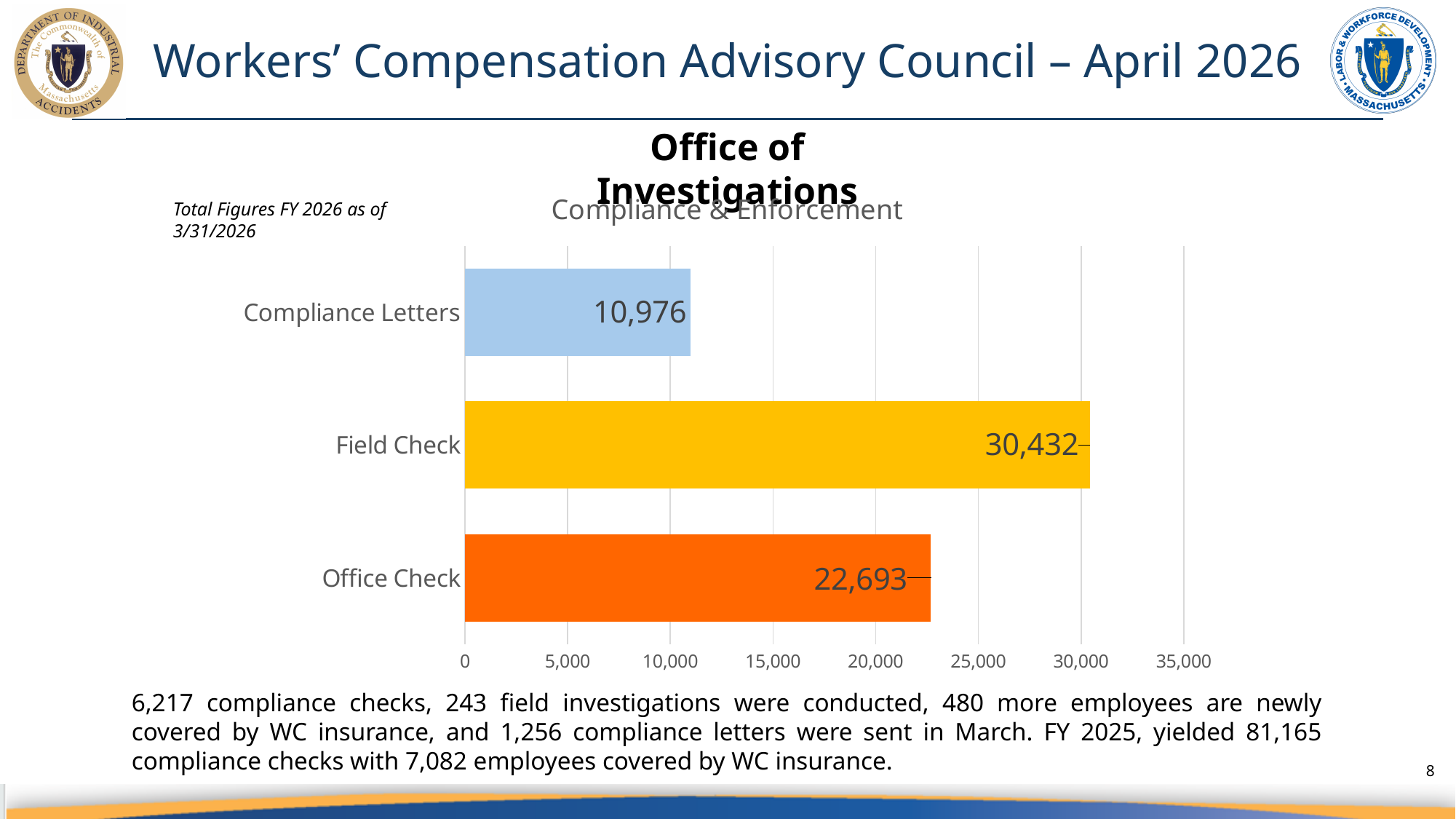
Which category has the lowest value? Compliance Letters How many categories are shown in the chart? 3 What kind of chart is shown on the slide? Bar chart What is the value for Field Check? 30,432 What colour is the Field Check bar? Yellow Which is larger, the value for Office Check or the value for Compliance Letters? Office Check Is the value for Field Check greater or less than 25,000? greater What is the difference between the Field Check and Office Check values? 7,739 What is the value for Office Check? 22,693 Which category has the highest value? Field Check What is the difference between the Office Check and Compliance Letters values? 11,717 What is the value for Compliance Letters? 10,976